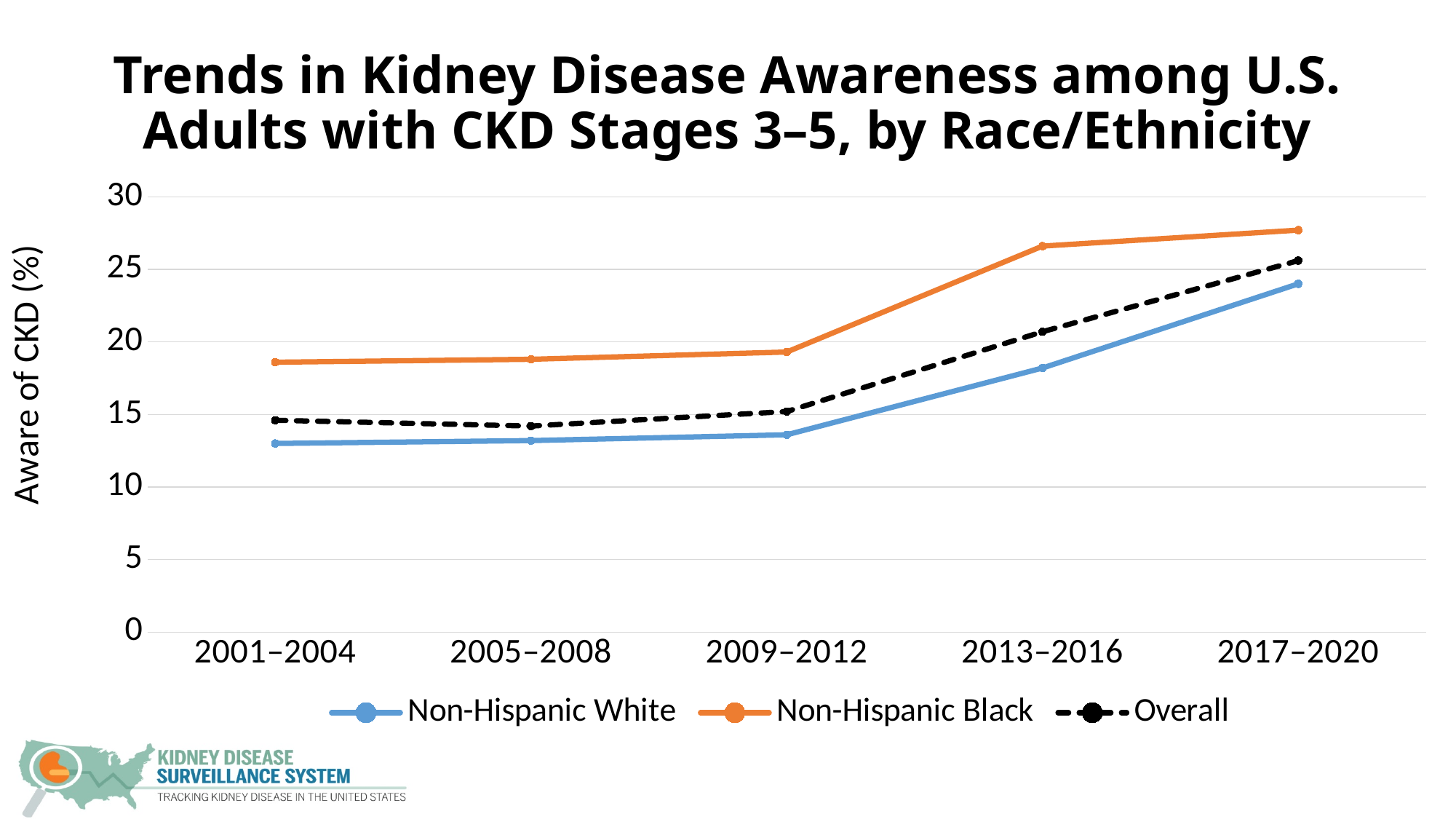
What is the label on the y axis? Aware of CKD (%) For Non-Hispanic White, which period has the highest value? 2017–2020 What kind of chart is shown on the slide? line chart Is the value for Non-Hispanic White in 2001–2004 greater or less than 15? less In 2013–2016, which is larger: Non-Hispanic Black or Non-Hispanic White? Non-Hispanic Black Which series has the highest value in 2017–2020? Non-Hispanic Black Do the values for Non-Hispanic White rise or fall from 2009–2012 to 2017–2020? rise How many series does the legend list? 3 Is the value for Non-Hispanic Black in 2001–2004 greater or less than 15? greater Is the value for Non-Hispanic Black in 2017–2020 greater or less than 25? greater How many time periods are shown on the x axis? 5